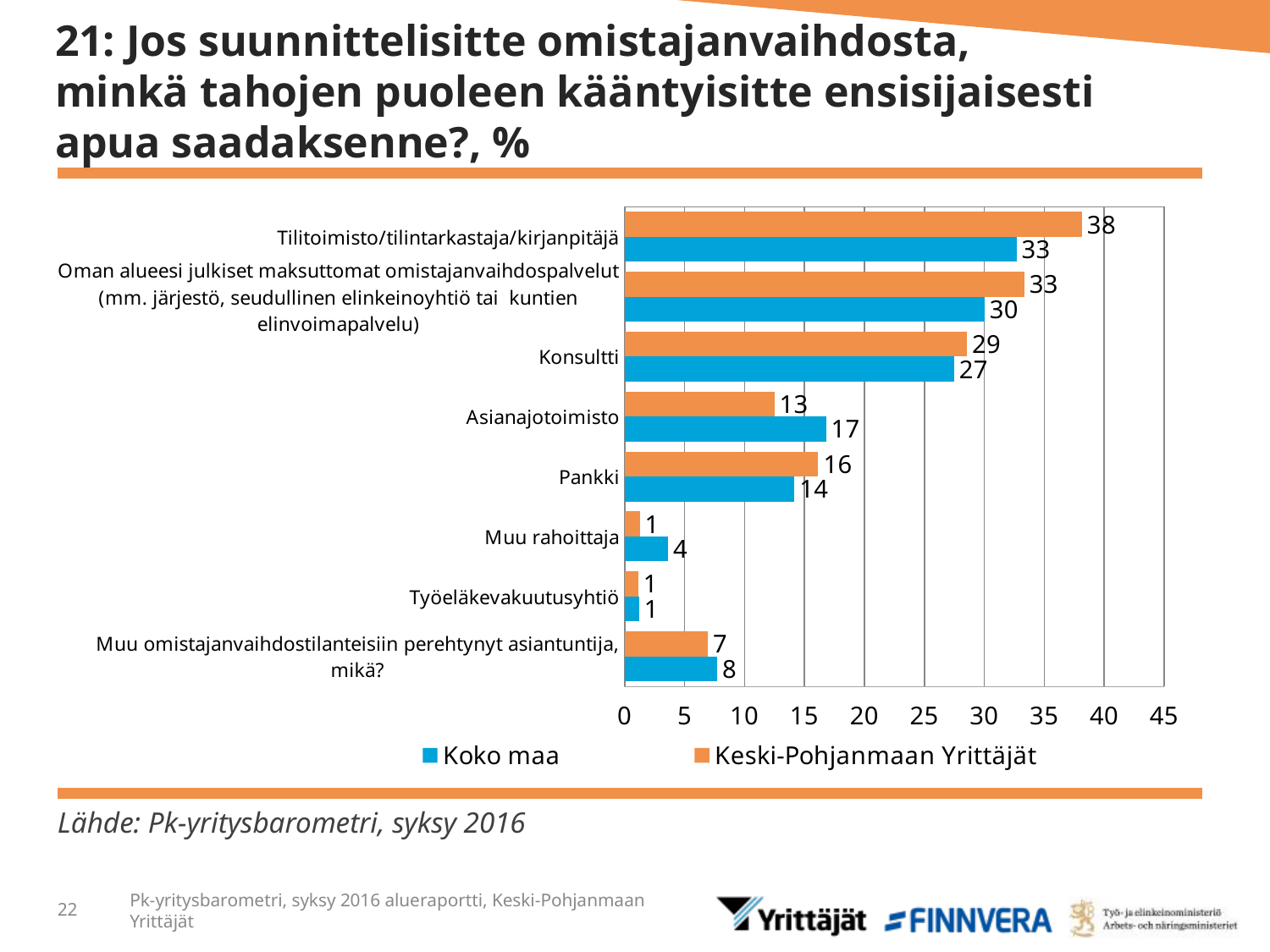
Which category has the highest value for Koko maa? Tilitoimisto/tilintarkastaja/kirjanpitäjä How many categories are shown in the chart? 8 What is the value for Keski-Pohjanmaan Yrittäjät for Tilitoimisto/tilintarkastaja/kirjanpitäjä? 38 What kind of chart is shown on the slide? bar chart For Muu rahoittaja, which series has the larger value, Koko maa or Keski-Pohjanmaan Yrittäjät? Koko maa How many series does the legend list? 2 What is the difference between the Keski-Pohjanmaan Yrittäjät and Koko maa values for Tilitoimisto/tilintarkastaja/kirjanpitäjä? 5 For Pankki, which series has the larger value, Koko maa or Keski-Pohjanmaan Yrittäjät? Keski-Pohjanmaan Yrittäjät What is the value for Koko maa for Asianajotoimisto? 17 Which series is shown in orange in the chart? Keski-Pohjanmaan Yrittäjät What is the value for Koko maa for Konsultti? 27 Which category has the lowest value for Koko maa? Työeläkevakuutusyhtiö